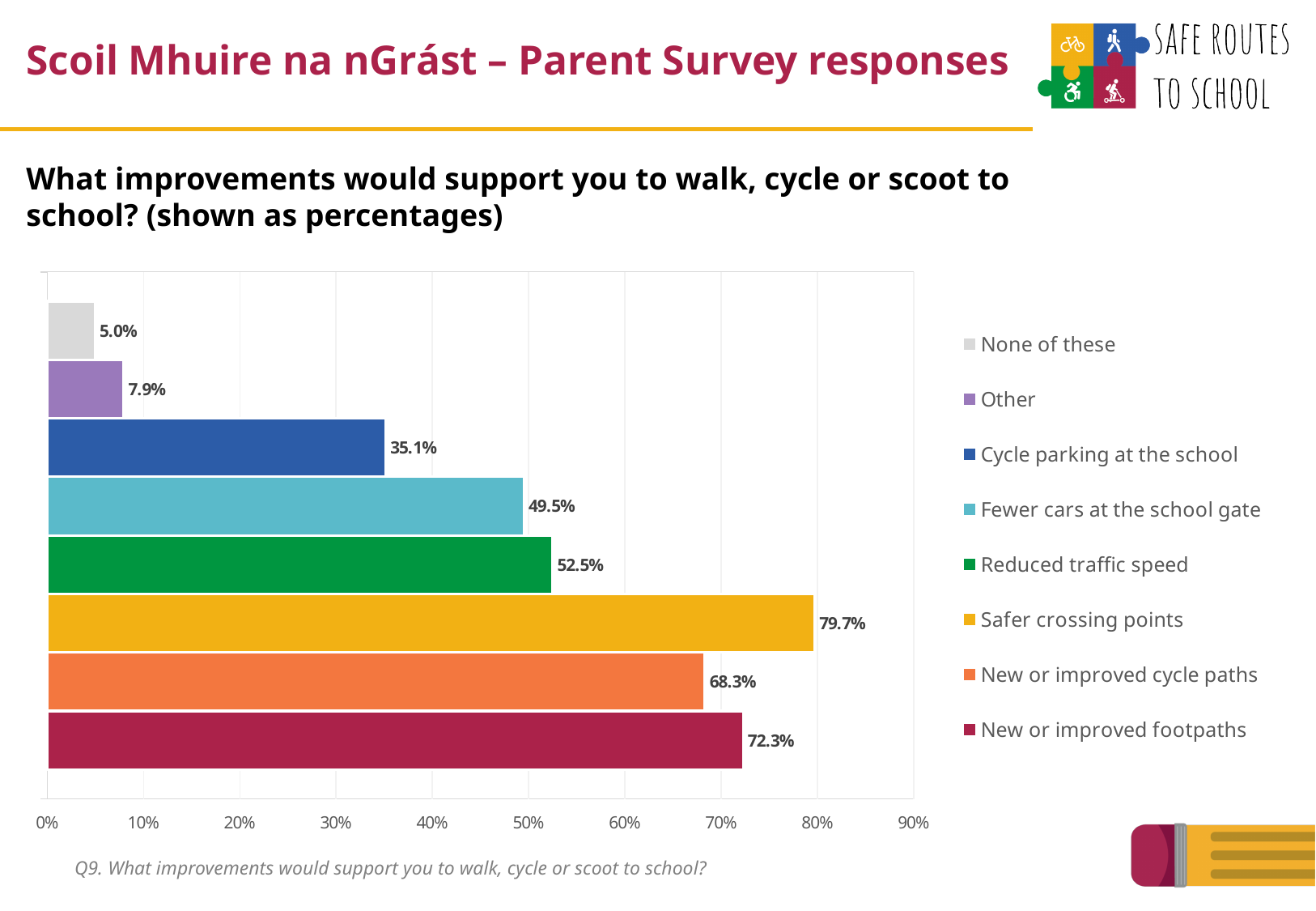
What colour is the bar for 'Reduced traffic speed'? Green Which is larger: 'Reduced traffic speed' or 'Fewer cars at the school gate'? Reduced traffic speed What is the value shown for 'Cycle parking at the school'? 35.1% What is the difference between 'Safer crossing points' and 'New or improved cycle paths'? 11.4% Is the value for 'New or improved cycle paths' greater or less than 60%? greater What is the difference between 'Other' and 'None of these'? 2.9% What kind of chart is shown on the slide? Bar chart How many categories are shown in the chart? 8 Which improvement has the highest percentage? Safer crossing points What percentage is shown for 'New or improved footpaths'? 72.3% Which category has the lowest percentage? None of these What percentage of parents selected 'Safer crossing points'? 79.7%